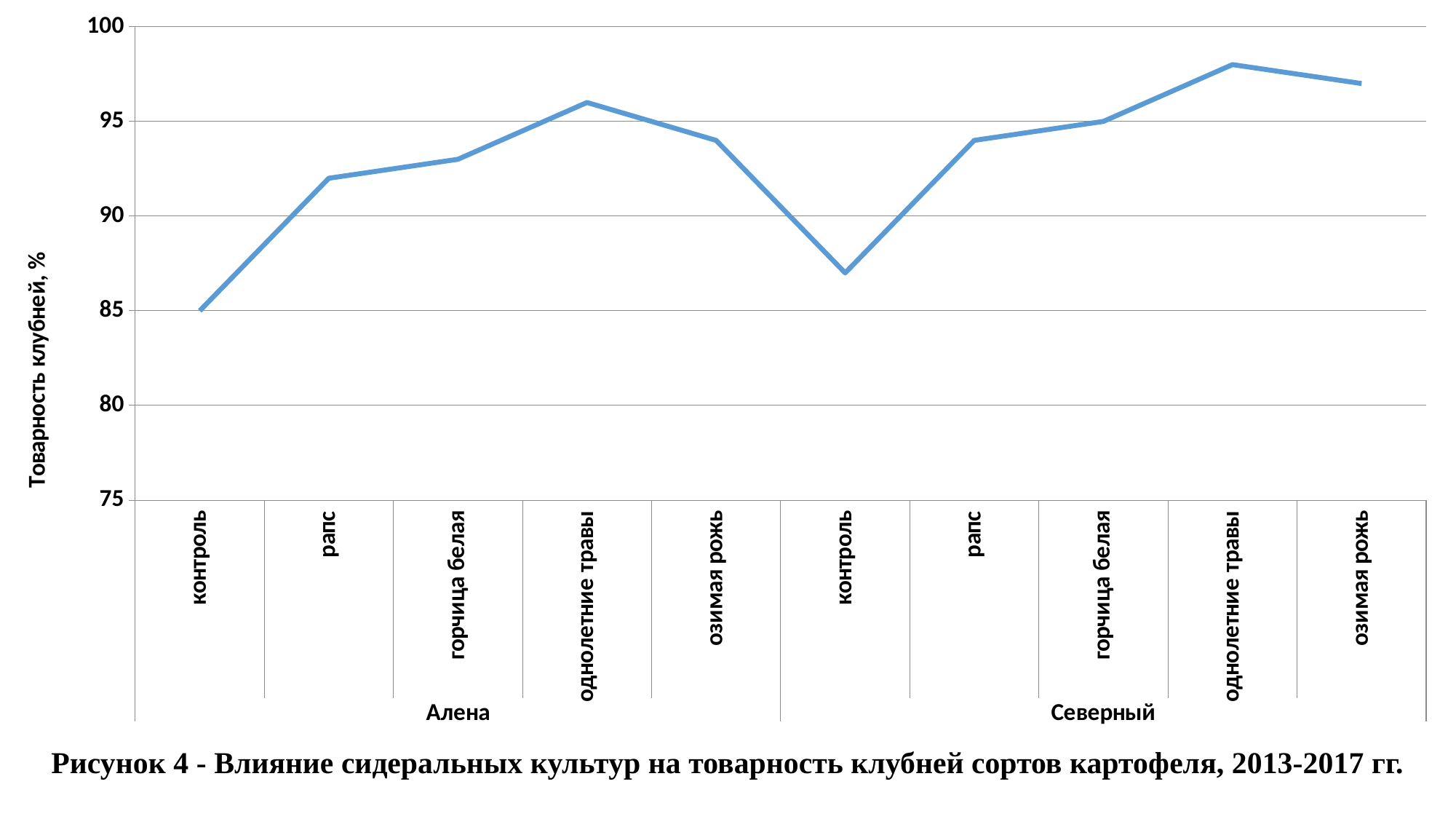
Is the value for контроль in the Северный group greater or less than 90? less How many data points are plotted on the chart? 10 Is the value for однолетние травы in the Алена group greater or less than 95? greater Which category has the lowest value on the chart? контроль (Алена) What is the label of the vertical axis? Товарность клубней, % What is the value for контроль in the Алена group? 85 Is the value for однолетние травы in the Северный group greater or less than 95? greater Which category has the highest value on the chart? однолетние травы (Северный) What kind of chart is shown on the slide? line chart What is the value for горчица белая in the Северный group? 95 Which is larger: the value for контроль in the Алена group or the value for контроль in the Северный group? контроль (Северный)